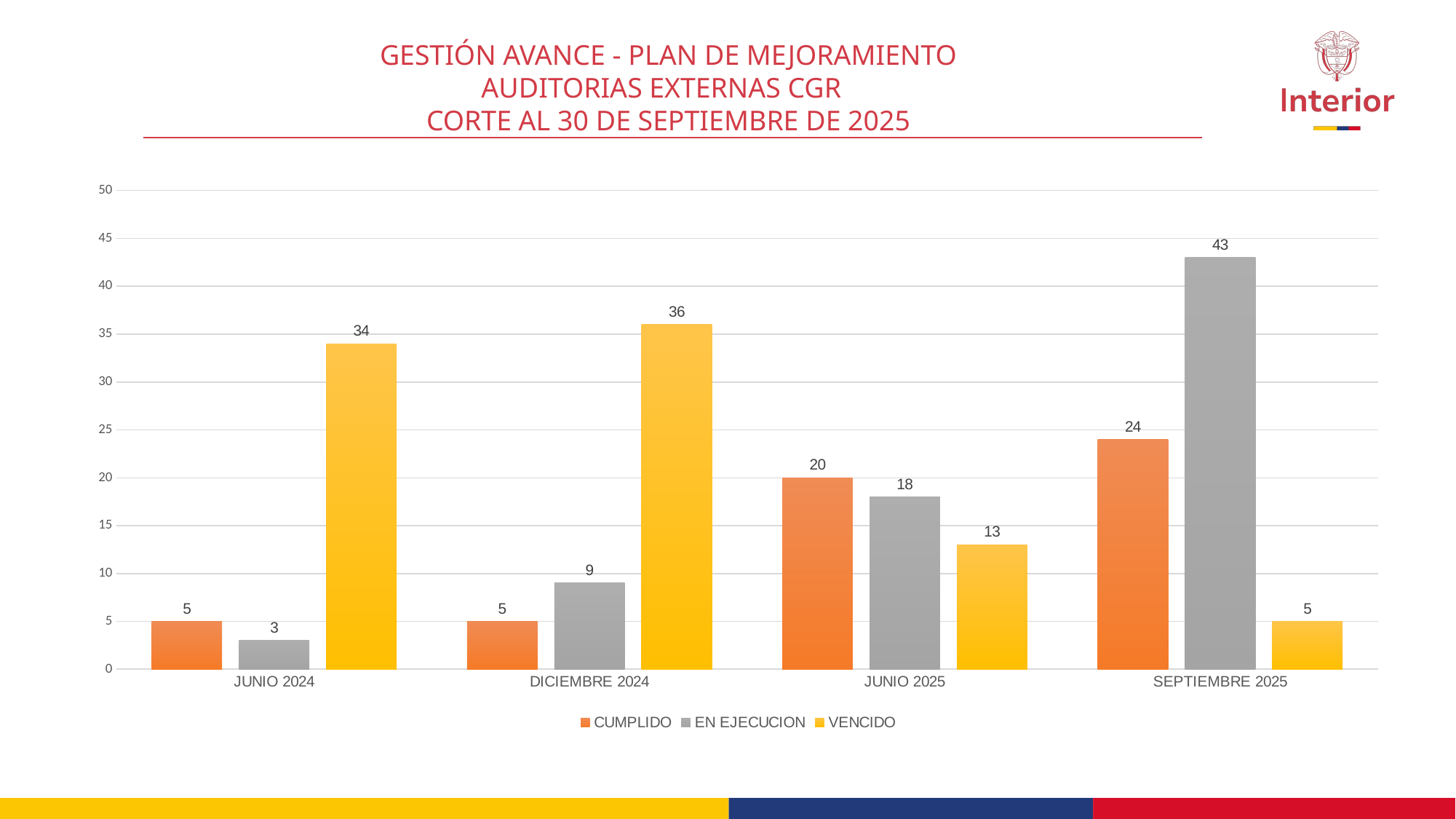
Does the CUMPLIDO value rise or fall from JUNIO 2024 to SEPTIEMBRE 2025? Rise What is the value for EN EJECUCION in SEPTIEMBRE 2025? 43 Which category has the lowest EN EJECUCION value? JUNIO 2024 Which is larger in JUNIO 2025: CUMPLIDO or EN EJECUCION? CUMPLIDO What is the difference between the VENCIDO values for JUNIO 2024 and SEPTIEMBRE 2025? 29 How many series does the legend list? 3 Which category has the highest VENCIDO value? DICIEMBRE 2024 What kind of chart is shown on the slide? Bar chart How many categories are shown on the x axis? 4 What colour represents the VENCIDO series in the legend? Yellow What is the value for CUMPLIDO in JUNIO 2025? 20 What is the value for VENCIDO in DICIEMBRE 2024? 36